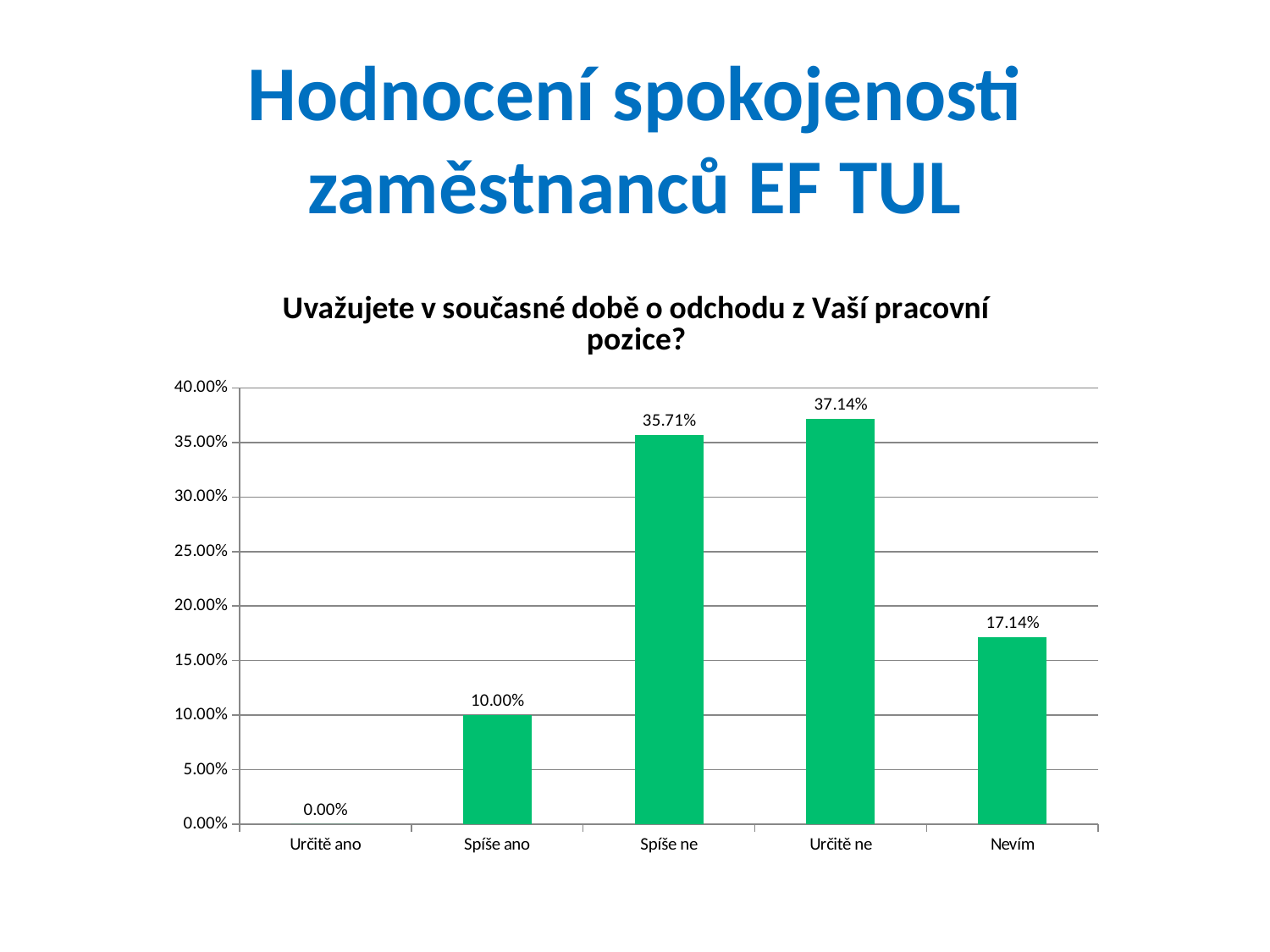
What kind of chart is shown on the slide? Bar chart What is the value for Nevím? 17.14% What is the difference between the values for Nevím and Spíše ano? 7.14% What is the title of the chart? Uvažujete v současné době o odchodu z Vaší pracovní pozice? What is the value for Spíše ano? 10.00% Which category has the lowest value? Určitě ano What is the value for Spíše ne? 35.71% What is the value for Určitě ano? 0.00% Which is larger, the value for Nevím or the value for Spíše ano? Nevím Which category has the highest value? Určitě ne How many categories are shown on the x axis? 5 What is the difference between the values for Určitě ne and Spíše ne? 1.43%